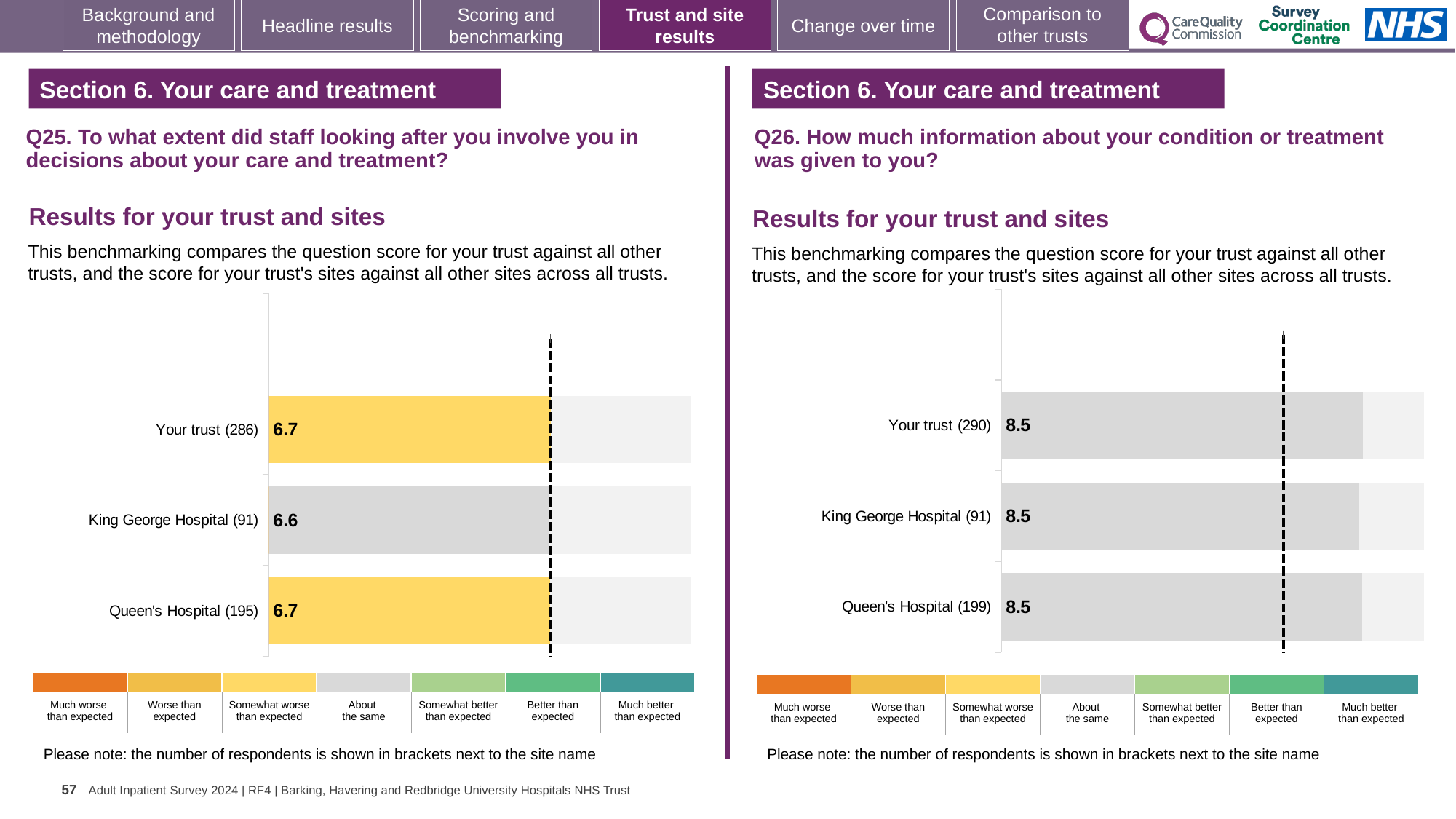
What kind of chart is the Q26 chart on the right? Bar chart In the Q25 chart on the left, what colour category does the Your trust bar fall into according to the legend? Somewhat worse than expected In the Q25 chart on the left, what is the score for Your trust? 6.7 In the Q25 chart on the left, how many respondents are shown for Queen's Hospital? 195 In the Q25 chart on the left, how many bars are plotted? 3 In the Q25 chart on the left, what is the difference between the scores for Queen's Hospital and King George Hospital? 0.1 In the Q26 chart on the right, what is the score for Your trust? 8.5 In the Q26 chart on the right, what is the score for Queen's Hospital? 8.5 In the Q25 chart on the left, what is the score for Queen's Hospital? 6.7 In the Q25 chart on the left, what is the score for King George Hospital? 6.6 In the Q25 chart on the left, which site has the lowest score? King George Hospital In the Q26 chart on the right, how many respondents are shown for Your trust? 290